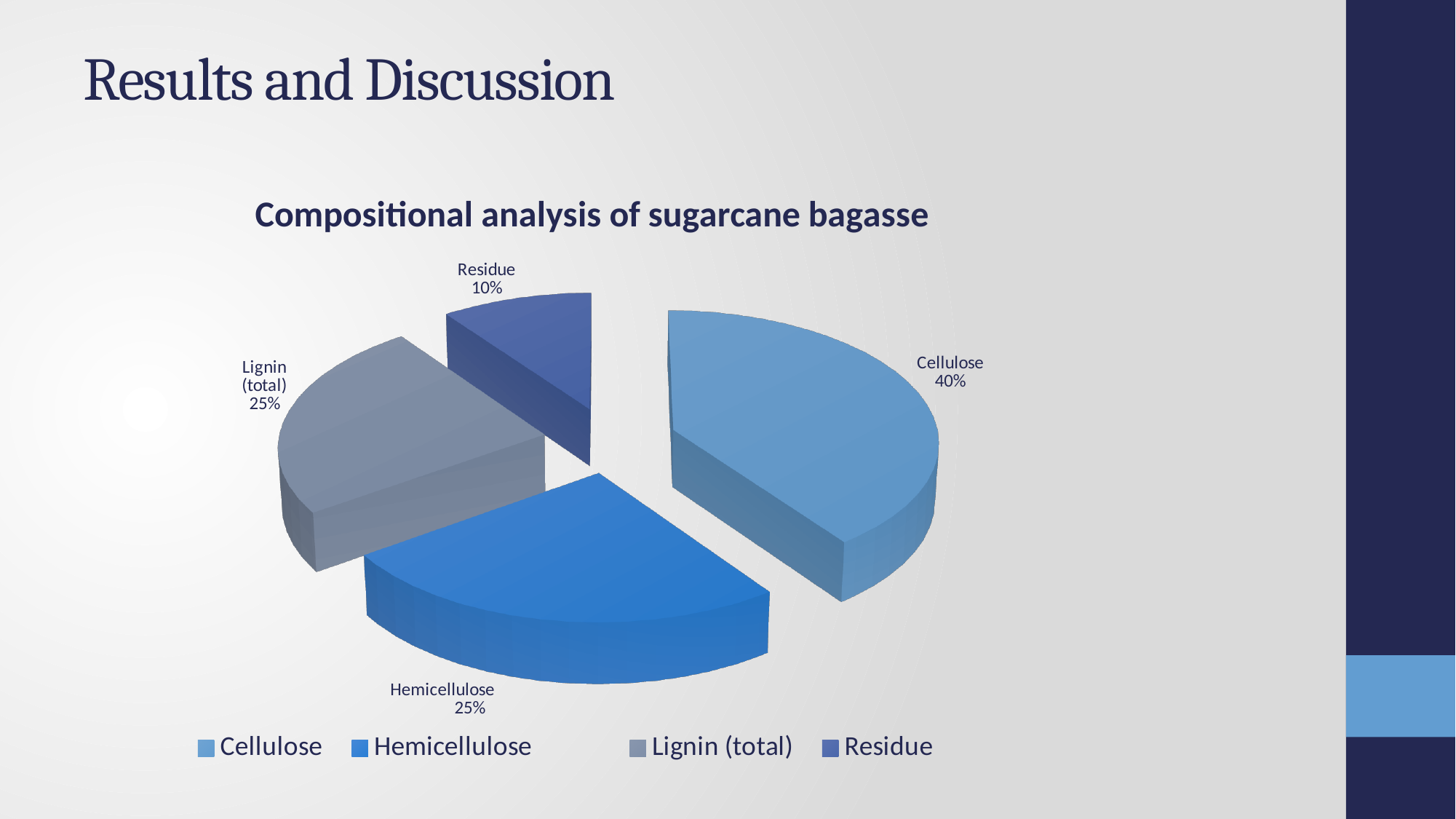
What share of the pie does Cellulose represent? 40% Which component has the largest share of the pie? Cellulose How many slices does the pie chart have? 4 What type of chart is shown on the slide? Pie chart What share of the pie does Hemicellulose represent? 25% What share of the pie does Lignin (total) represent? 25% What is the title of the chart? Compositional analysis of sugarcane bagasse Which component has the smallest share of the pie? Residue Which is larger, the share for Cellulose or the share for Hemicellulose? Cellulose How many entries does the legend list? 4 What is the difference in percentage points between the Cellulose and Residue shares? 30